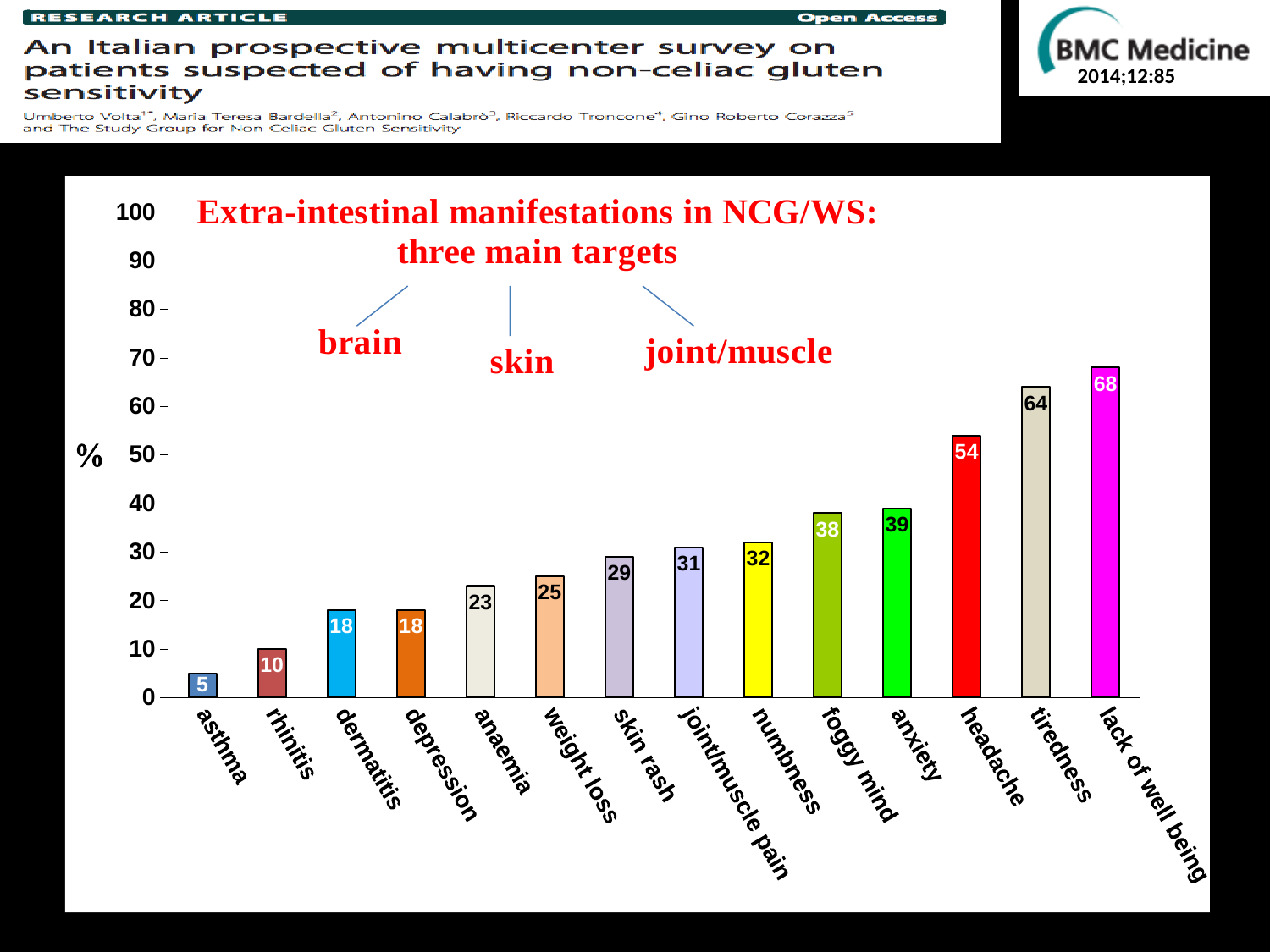
What is the label on the y axis? % What kind of chart is shown? bar chart Which category has the lowest value? asthma Is the value for skin rash greater or less than 20? greater How many categories are shown on the x axis? 14 What is the difference between the values for tiredness and headache? 10 What is the value for foggy mind? 38 Do the values rise or fall from left to right along the x axis? rise Which category has the highest value? lack of well being What is the value for asthma? 5 Which is larger, the value for anxiety or the value for numbness? anxiety What is the value for headache? 54